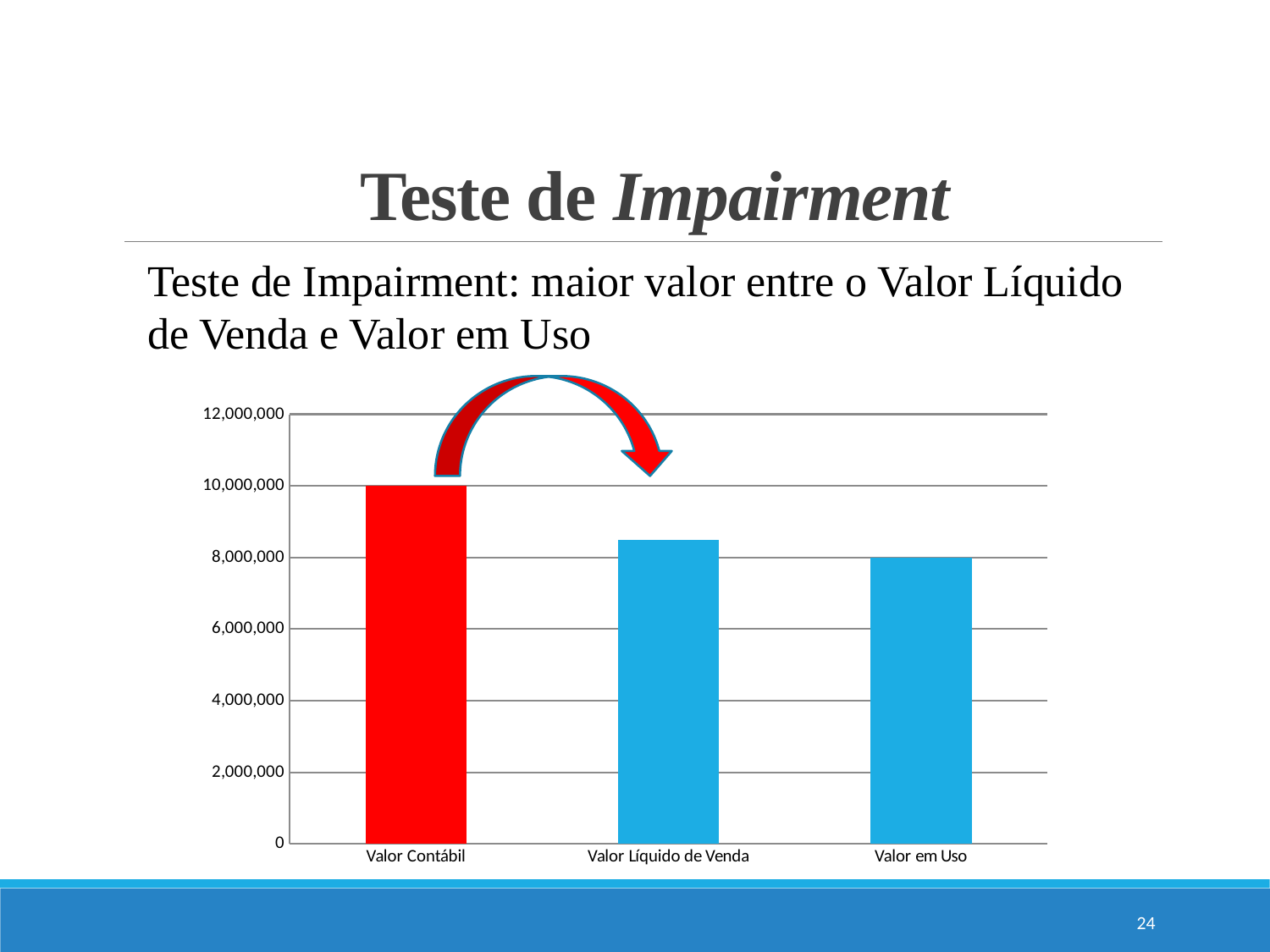
What is the value for Valor Contábil? 10,000,000 Which is larger, the value for Valor Líquido de Venda or the value for Valor em Uso? Valor Líquido de Venda Which category has the lowest value? Valor em Uso What kind of chart is shown on the slide? bar chart What is the difference between the values for Valor Contábil and Valor em Uso? 2,000,000 Is the value for Valor Líquido de Venda greater or less than 8,000,000? greater What is the value for Valor em Uso? 8,000,000 How many categories are shown on the x axis? 3 Do the values rise or fall from left to right along the x axis? fall Is the value for Valor Líquido de Venda greater or less than 10,000,000? less Which category has the highest value? Valor Contábil Which is larger, the value for Valor Contábil or the value for Valor Líquido de Venda? Valor Contábil